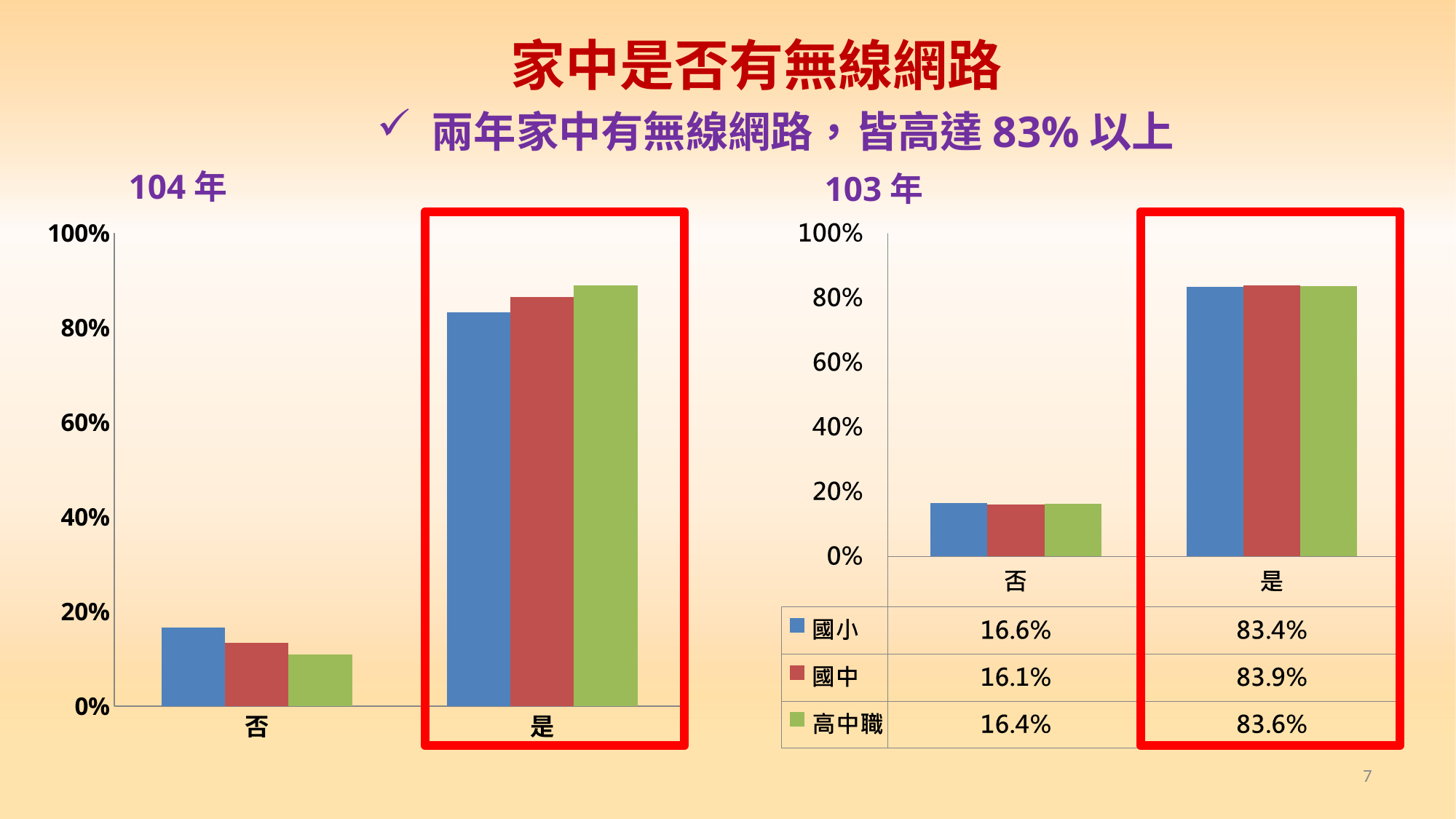
In the 104 年 chart, is the value of the blue bar for 是 greater or less than 80%? greater What kind of chart is the 104 年 chart? bar chart In the 103 年 chart, what is the value for 國中 in the 否 category? 16.1% In the 104 年 chart, how many categories are shown on the x axis? 2 In the 104 年 chart, which category has the larger blue bar, 否 or 是? 是 In the 103 年 chart, which series has the lowest value in the 否 category? 國中 In the 103 年 chart, what is the value for 國小 in the 是 category? 83.4% In the 104 年 chart, is the value of the green bar for 否 greater or less than 20%? less In the 103 年 chart, how many series does the legend list? 3 In the 103 年 chart, which series has the highest value in the 是 category? 國中 In the 103 年 chart, what is the value for 高中職 in the 是 category? 83.6% In the 103 年 chart, what is the difference between the 是 values for 國中 and 國小? 0.5%